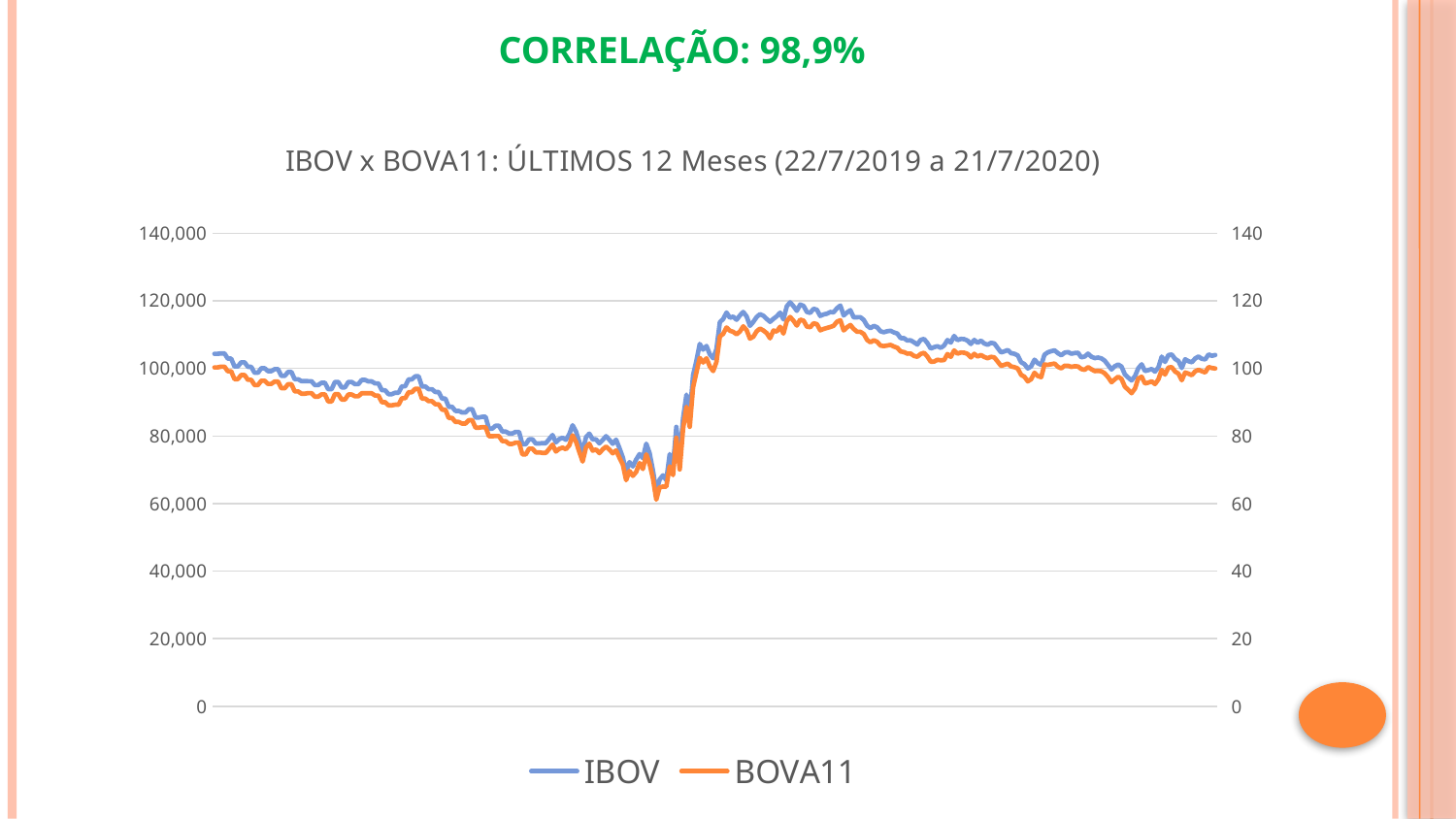
Which series dips to the lower minimum during the sharp drop, IBOV or BOVA11? BOVA11 Is the lowest point of the IBOV line greater or less than 60,000 on the left axis? greater What are the two series named in the legend? IBOV and BOVA11 How many series does the legend list? 2 What correlation value is stated in the heading above the chart? 98,9% Is the lowest value reached by the BOVA11 line greater or less than 80 on the right axis? less Which series line sits above the other for most of the period, IBOV or BOVA11? IBOV What is the maximum value shown on the left vertical axis? 140,000 Is the highest value reached by the IBOV line greater or less than 100,000 on the left axis? greater What kind of chart is shown on the slide? line chart